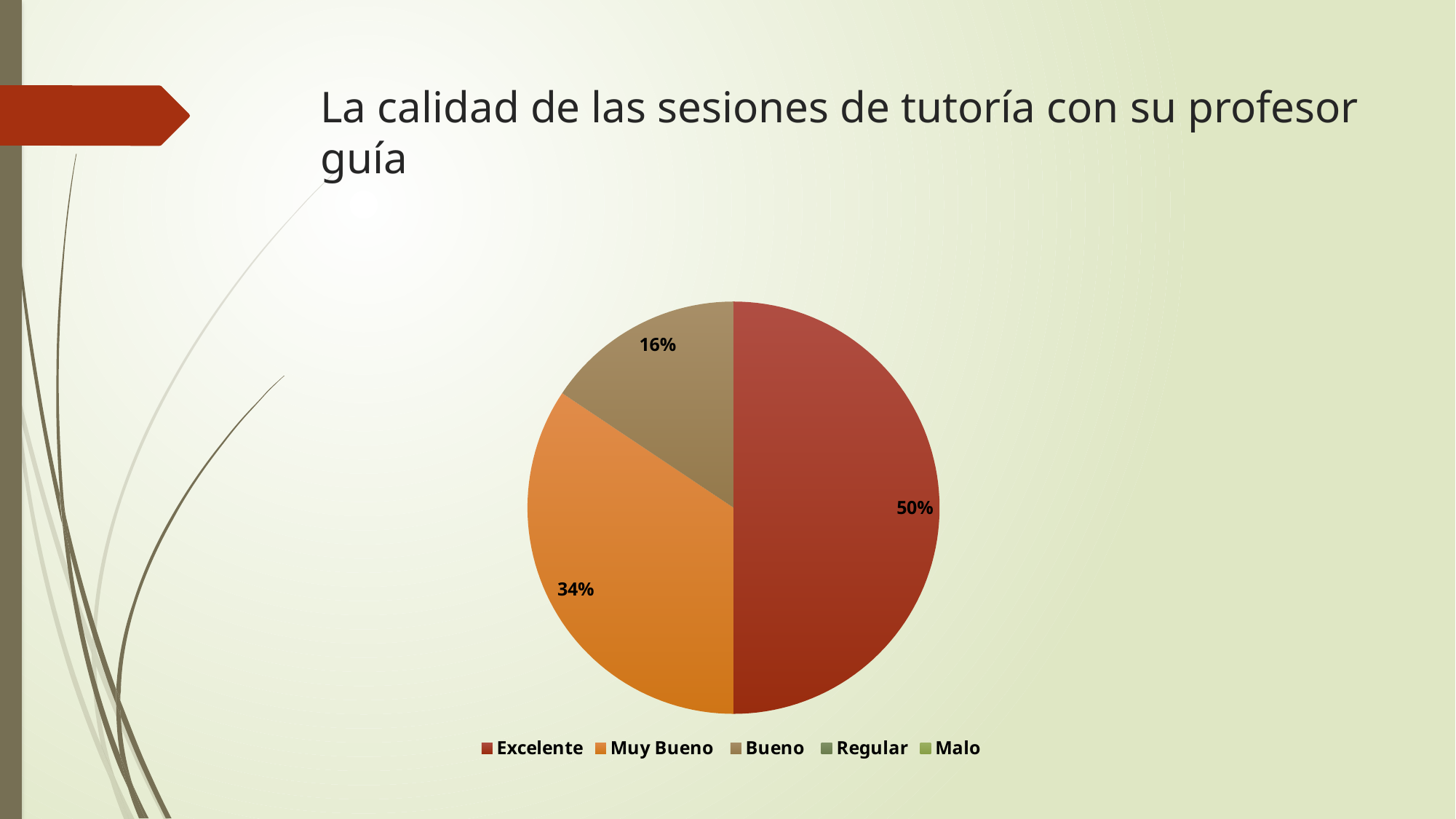
Which category has the largest slice of the pie? Excelente What is the difference in percentage points between Muy Bueno and Bueno? 18% Which of the visible slices is the smallest? Bueno Which is larger, the Muy Bueno slice or the Bueno slice? Muy Bueno How many categories does the legend list? 5 What share of the pie does Bueno have? 16% What is the title of the slide containing the chart? La calidad de las sesiones de tutoría con su profesor guía What share of the pie does Excelente have? 50% What kind of chart is shown on the slide? pie chart What colour is the Excelente slice? red What is the difference in percentage points between Excelente and Muy Bueno? 16% What share of the pie does Muy Bueno have? 34%